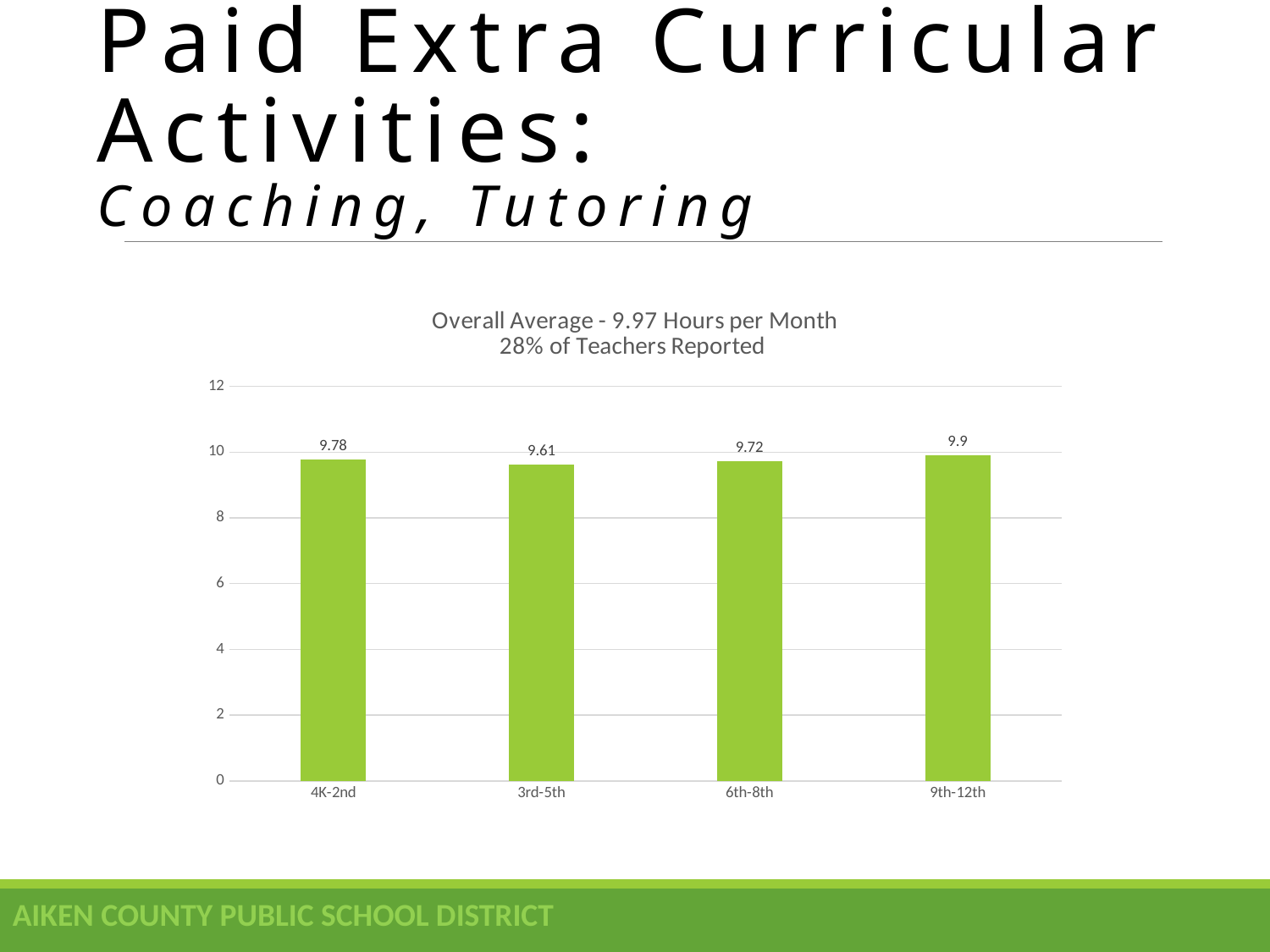
What is the difference between the values for 9th-12th and 3rd-5th? 0.29 What is the value for 6th-8th? 9.72 What is the value for 4K-2nd? 9.78 Which grade band has the highest value? 9th-12th What is the value for 3rd-5th? 9.61 What is the value for 9th-12th? 9.9 Which is larger, the value for 4K-2nd or the value for 6th-8th? 4K-2nd Is the value for 9th-12th greater or less than 10? less What overall average is stated in the chart title? 9.97 Hours per Month Which grade band has the lowest value? 3rd-5th What kind of chart is shown on the slide? bar chart How many grade bands are shown on the chart? 4